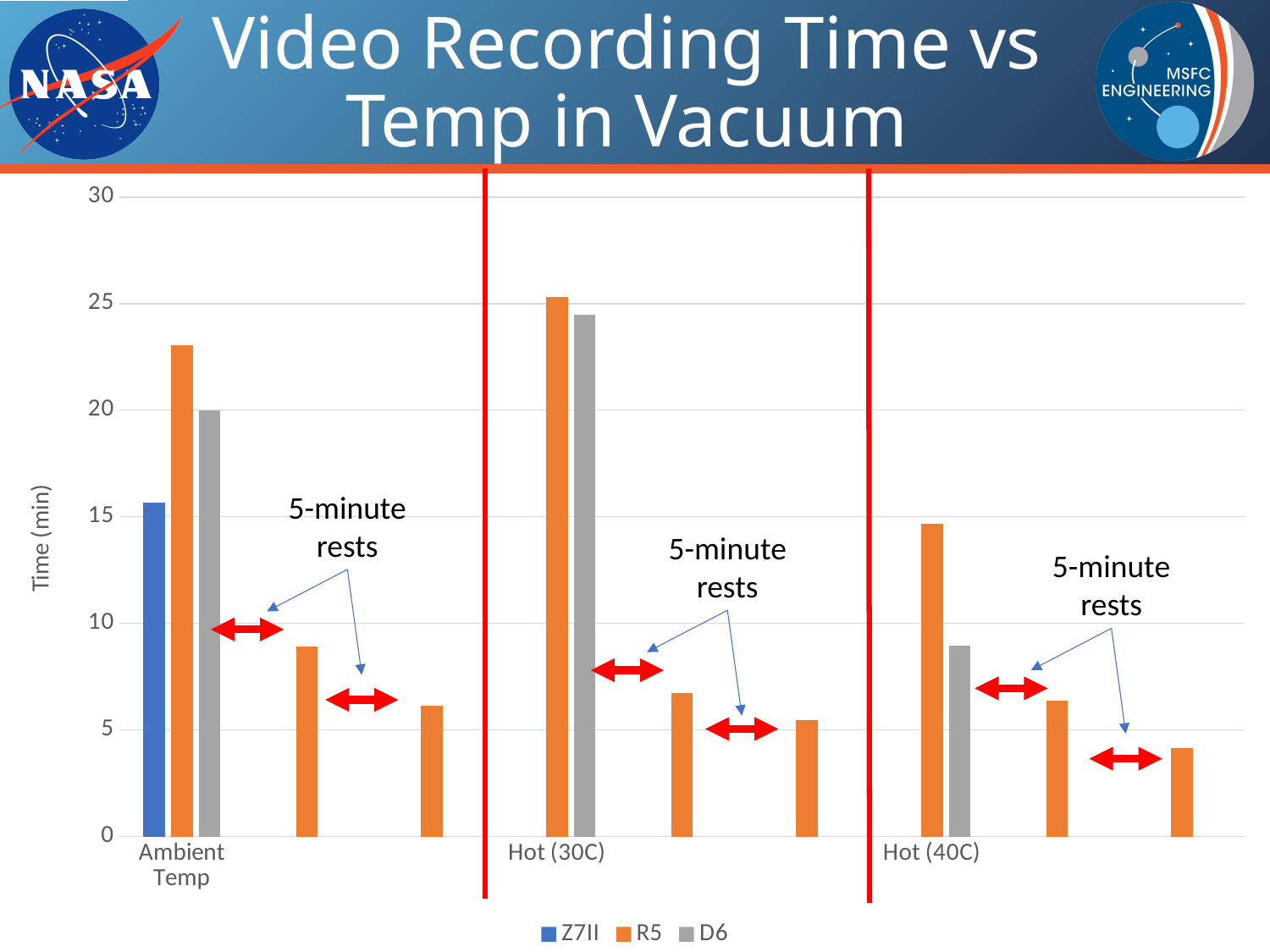
How many temperature categories are labelled on the x axis? 3 What kind of chart is shown on the slide? bar chart Which temperature category is the only one with a Z7II bar? Ambient Temp What are the series names listed in the legend? Z7II, R5, D6 Is the value of the first R5 bar at Ambient Temp greater or less than 20? greater Which temperature category contains the tallest bar on the chart? Hot (30C) Is the value of the Z7II bar at Ambient Temp greater or less than 20? less How many series does the legend list? 3 Is the value of the first R5 bar at Hot (40C) greater or less than 10? greater At Hot (40C), which is larger: the first R5 bar or the D6 bar? R5